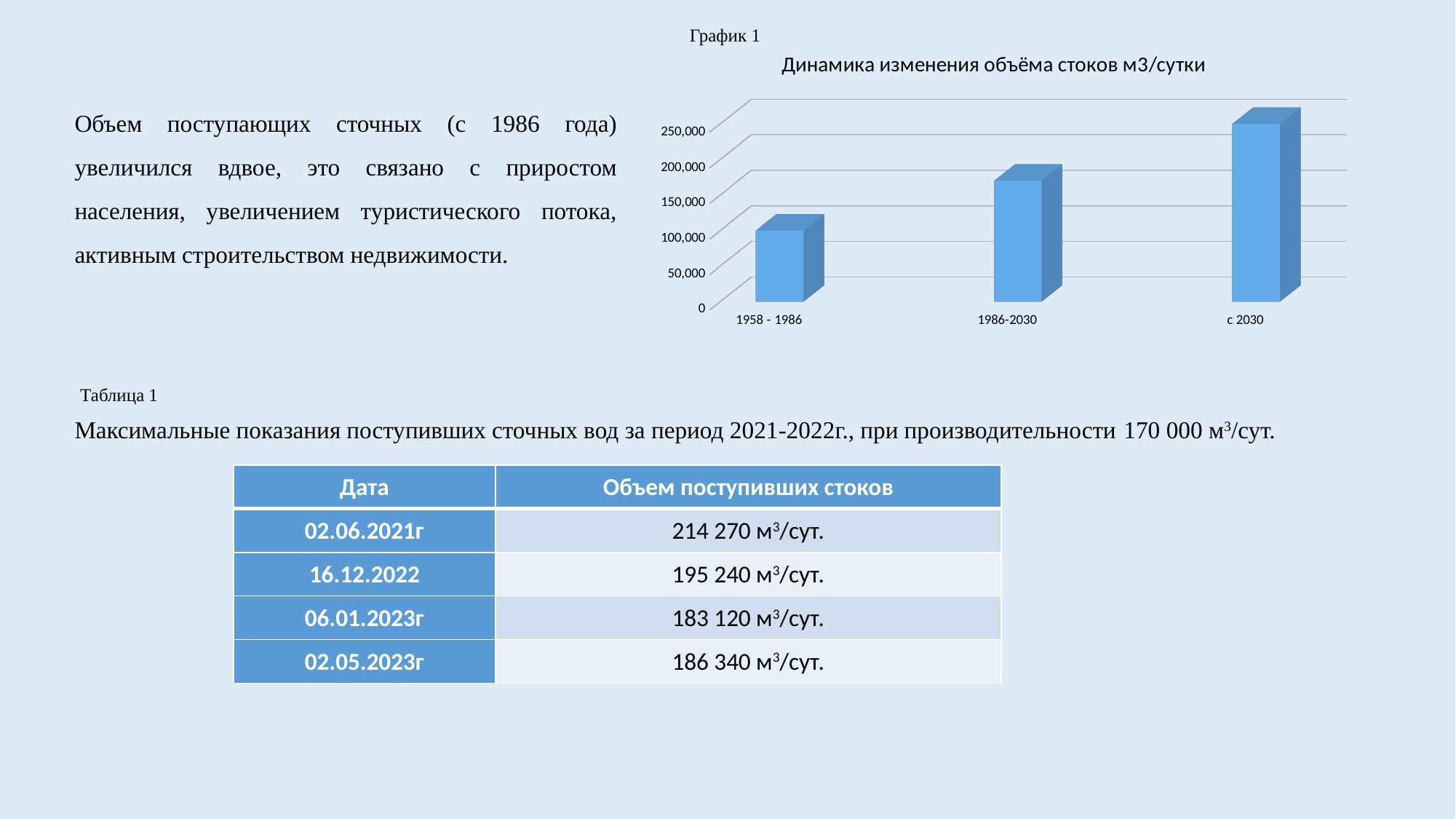
What is the highest tick label shown on the vertical axis of the chart? 250,000 Is the value for с 2030 greater or less than 200,000? greater Which category has the lowest value in the chart? 1958 - 1986 Is the value for 1986-2030 greater or less than 200,000? less Which is larger in the chart: the value for 1986-2030 or the value for 1958 - 1986? 1986-2030 Which category has the highest value in the chart? с 2030 What kind of chart is shown on the slide? bar chart Is the value for 1958 - 1986 greater or less than 150,000? less What is the title of the chart? Динамика изменения объёма стоков м3/сутки Do the values in the chart rise or fall from left to right along the x axis? rise How many categories are shown on the x axis of the chart? 3